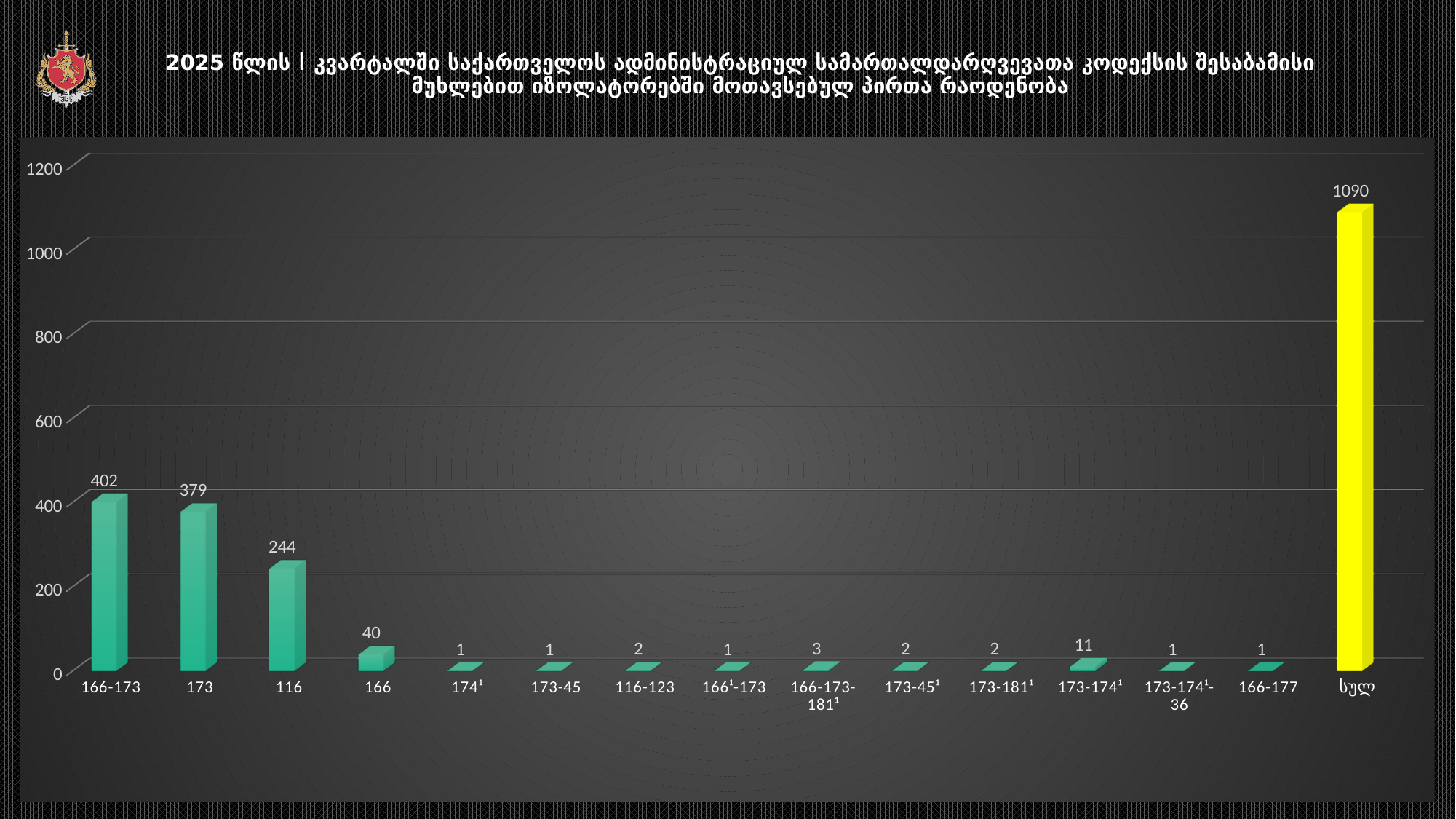
Which is larger, the value for 173 or the value for 116? 173 What is the value shown for the yellow bar labelled სულ? 1090 How many categories are shown on the x axis? 15 What is the difference between the values for 116 and 166? 204 What is the value for the category 116? 244 What is the value for the category 173-174¹? 11 What is the value for the category 166-173? 402 Which category has the highest value? სულ What kind of chart is shown on the slide? bar chart What is the difference between the values for 166-173 and 173? 23 What is the value for the category 173? 379 What colour is the bar for the category სულ? yellow